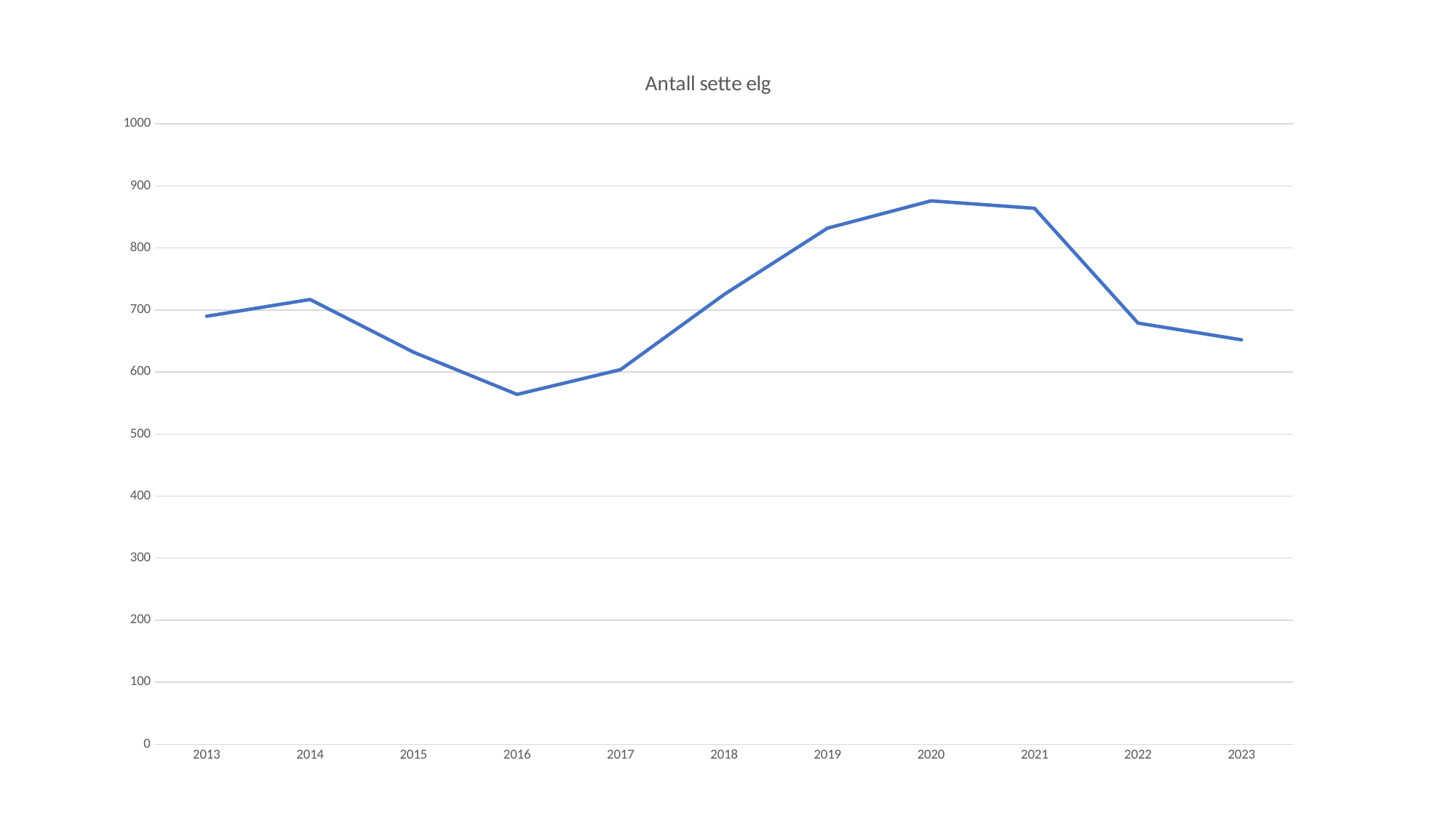
How many years are plotted along the x axis? 11 Which is larger, the value for 2016 or the value for 2017? 2017 Which year has the lowest value? 2016 What kind of chart is shown on the slide? line chart Is the value for 2018 greater or less than 700? greater Is the value for 2019 greater or less than 800? greater Is the value for 2016 greater or less than 600? less Do the values rise or fall from 2016 to 2020? rise Which is larger, the value for 2019 or the value for 2022? 2019 What is the title of the chart? Antall sette elg